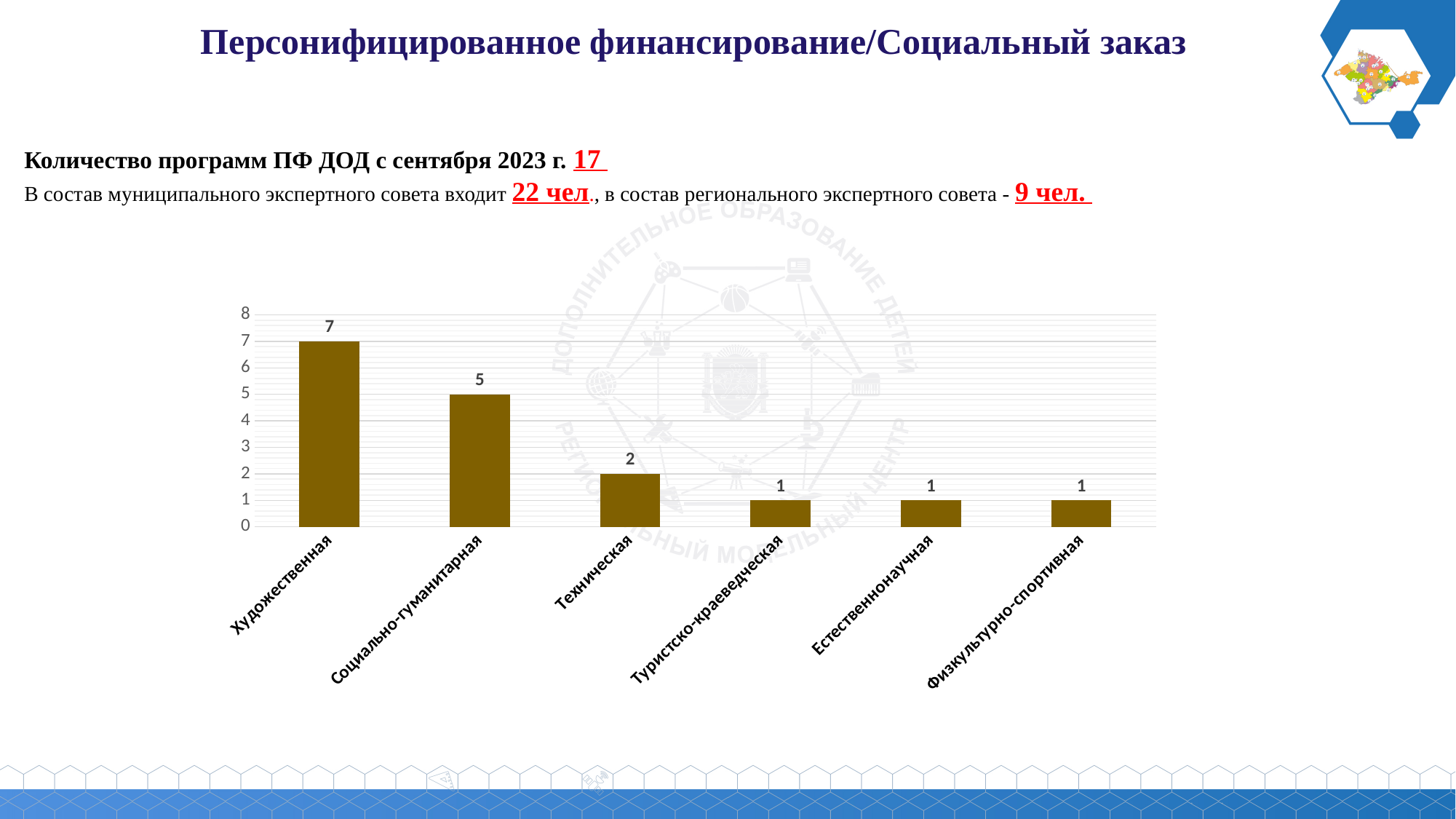
What is the value for Художественная? 7 What is the value for Социально-гуманитарная? 5 What is the value for Техническая? 2 What is the difference between the values for Социально-гуманитарная and Техническая? 3 What is the highest value shown on the vertical axis? 8 What kind of chart is shown on the slide? Bar chart Which category has the highest value? Художественная How many categories are shown in the chart? 6 What is the value for Туристско-краеведческая? 1 What is the difference between the values for Художественная and Социально-гуманитарная? 2 Which is larger, the value for Техническая or the value for Естественнонаучная? Техническая Do the values rise or fall from left to right along the x axis? Fall